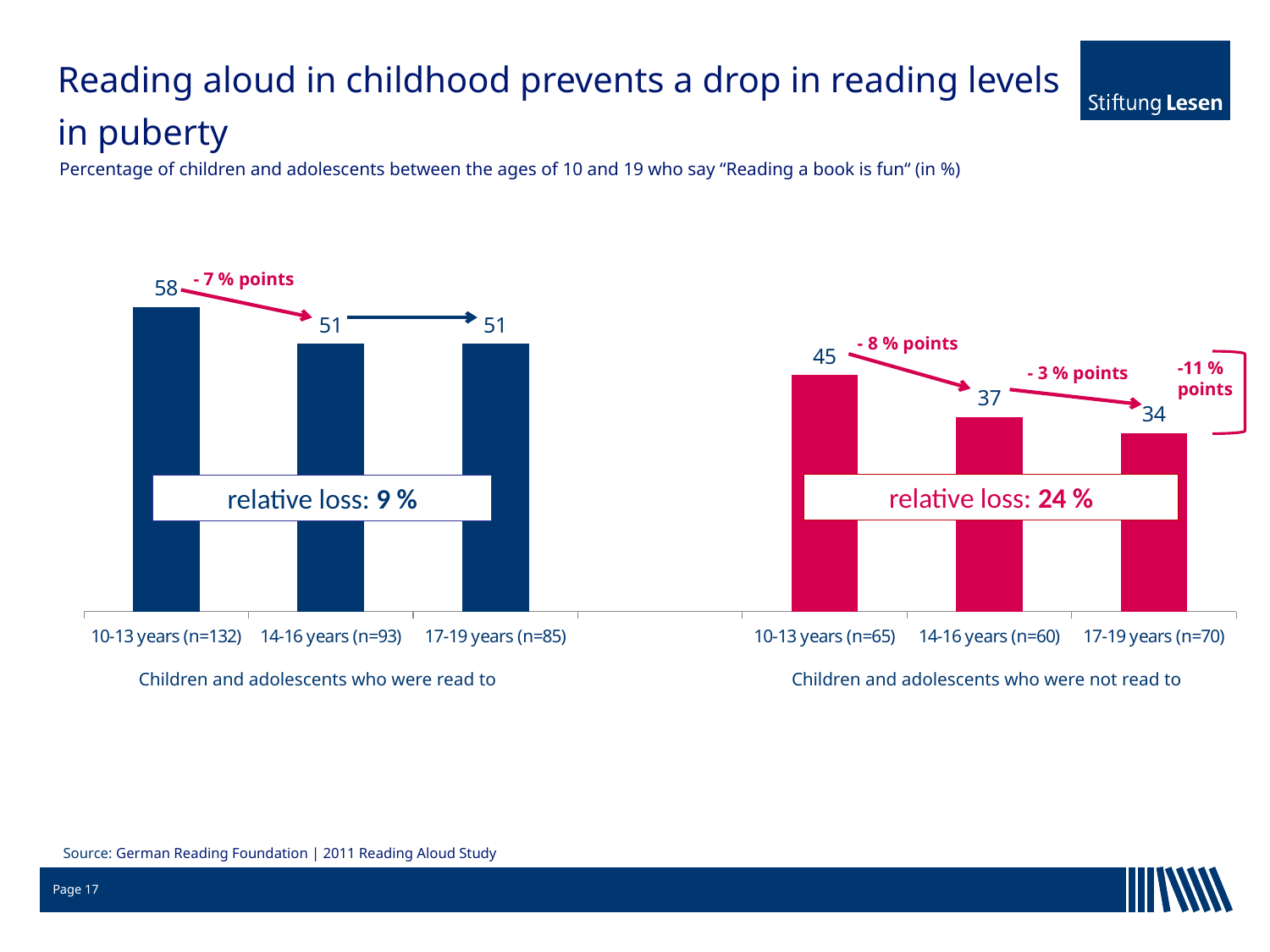
How many age groups are shown in the chart for children and adolescents who were not read to? 3 Which is larger: the value for 17-19 years among children who were read to, or the value for 17-19 years among children who were not read to? Children who were read to (51) In the chart for children and adolescents who were read to, which age group has the highest value? 10-13 years (n=132) What kind of chart is used on this slide? Bar chart In the chart for children and adolescents who were not read to, which age group has the lowest value? 17-19 years (n=70) In the chart for children and adolescents who were read to, what is the value for 10-13 years (n=132)? 58 What relative loss is stated for children and adolescents who were not read to? 24 % In the chart for children and adolescents who were not read to, what is the value for 14-16 years (n=60)? 37 In the chart for children and adolescents who were not read to, what is the difference between the values for 10-13 years (n=65) and 17-19 years (n=70)? 11 In the chart for children and adolescents who were read to, what is the difference between the values for 10-13 years (n=132) and 14-16 years (n=93)? 7 In the chart for children and adolescents who were not read to, what is the value for 17-19 years (n=70)? 34 In the chart for children and adolescents who were not read to, do the values rise or fall across the age groups from left to right? Fall